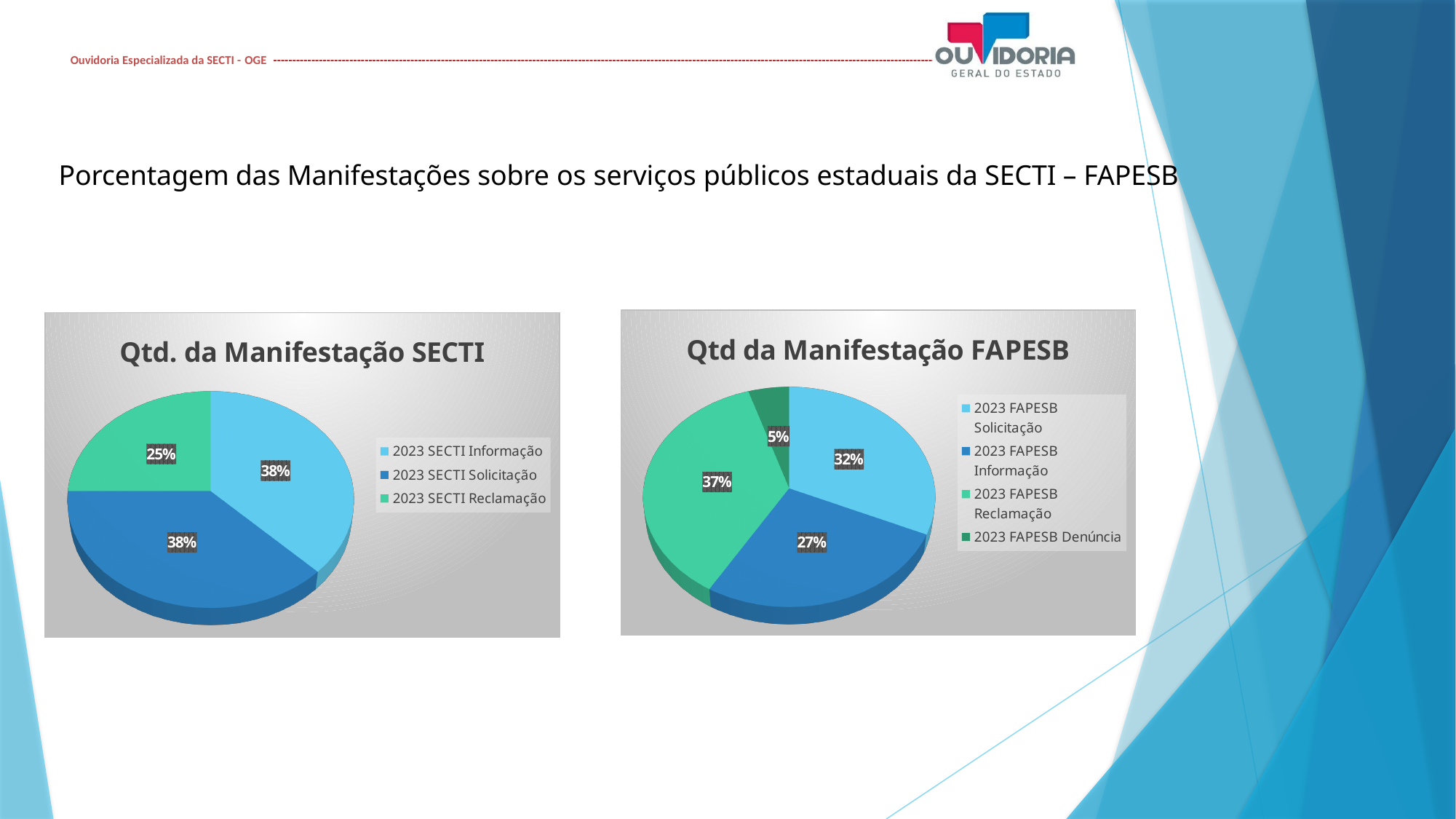
How many entries does the legend of the chart titled "Qtd da Manifestação FAPESB" list? 4 In the chart titled "Qtd. da Manifestação SECTI", what percentage is shown for 2023 SECTI Solicitação? 38% In the chart titled "Qtd. da Manifestação SECTI", how many slices does the pie have? 3 In the chart titled "Qtd da Manifestação FAPESB", which category has the largest slice? 2023 FAPESB Reclamação In the chart titled "Qtd da Manifestação FAPESB", which category has the smallest slice? 2023 FAPESB Denúncia In the chart titled "Qtd da Manifestação FAPESB", what percentage is shown for 2023 FAPESB Informação? 27% In the chart titled "Qtd da Manifestação FAPESB", what is the difference in percentage points between 2023 FAPESB Reclamação and 2023 FAPESB Informação? 10 percentage points In the chart titled "Qtd. da Manifestação SECTI", which category has the smallest slice? 2023 SECTI Reclamação In the chart titled "Qtd da Manifestação FAPESB", which is larger: 2023 FAPESB Solicitação or 2023 FAPESB Informação? 2023 FAPESB Solicitação In the chart titled "Qtd da Manifestação FAPESB", what percentage is shown for 2023 FAPESB Denúncia? 5% What kind of chart is "Qtd. da Manifestação SECTI"? Pie chart In the chart titled "Qtd. da Manifestação SECTI", what percentage is shown for 2023 SECTI Reclamação? 25%